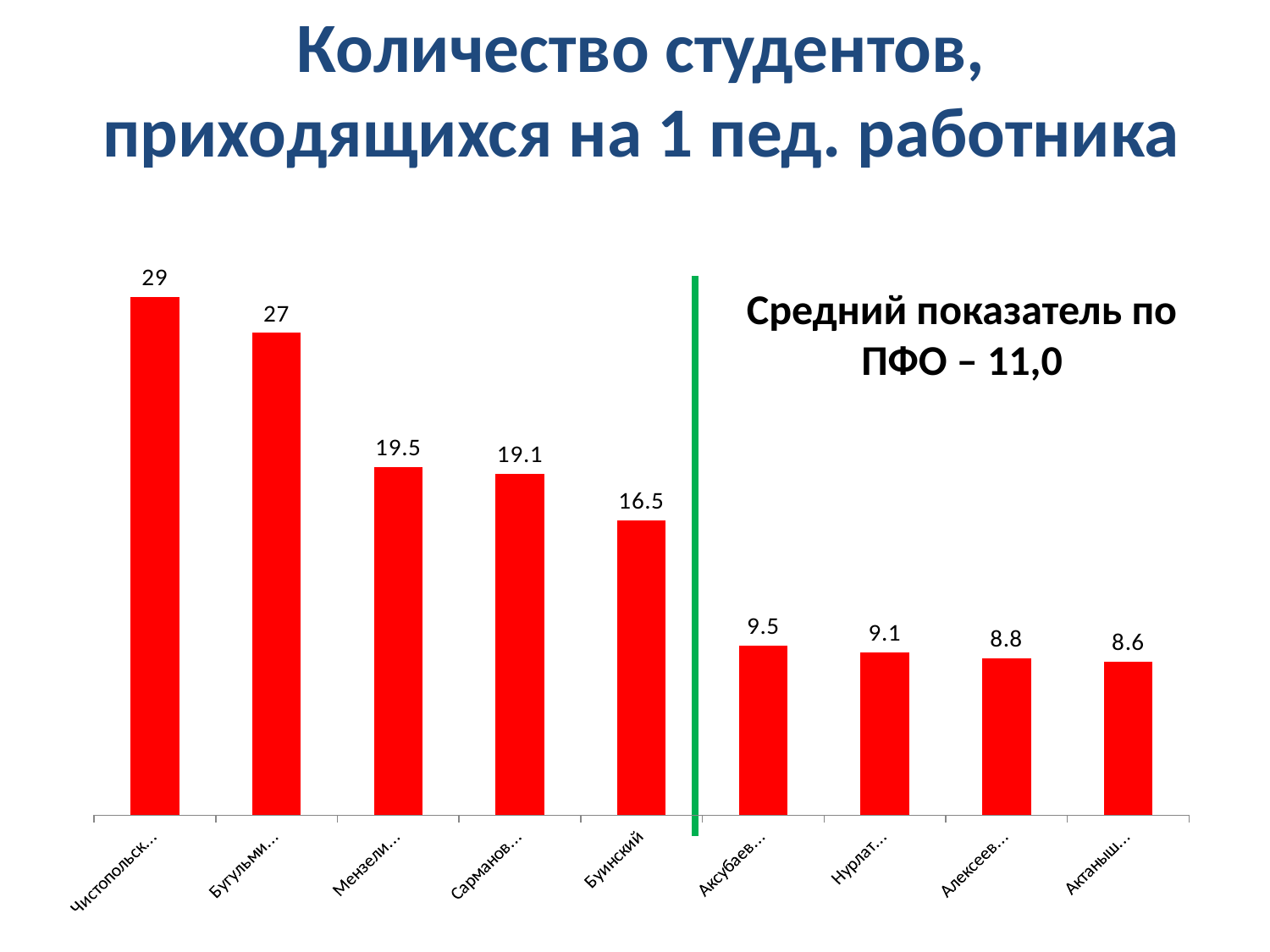
Which is larger: the value for Буинский or the value of the first bar? the first bar What is the difference between the value for Буинский and the bar immediately to its right? 7 Do the values rise or fall from left to right along the x axis? fall What is the value of the first (leftmost) bar? 29 What kind of chart is shown on the slide? bar chart What is the highest value shown in the chart? 29 What is the difference between the first bar (29) and the second bar (27)? 2 What is the lowest value shown in the chart? 8.6 How many bars are shown in the chart? 9 What average value for ПФО is stated on the slide? 11,0 What is the value of the last (rightmost) bar? 8.6 What is the value for Буинский? 16.5